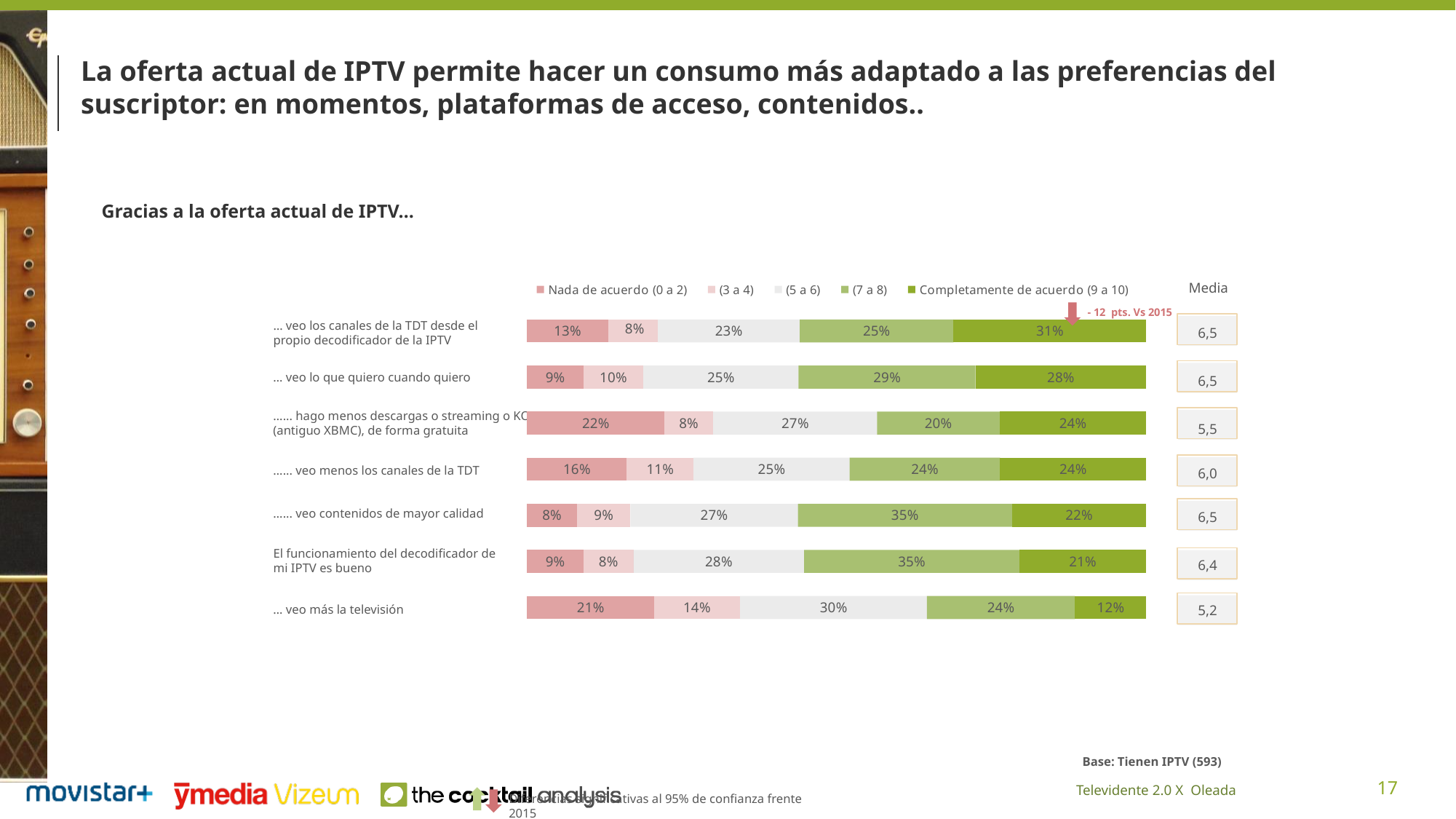
What colour represents the 'Nada de acuerdo (0 a 2)' series in the legend? Red/pink How many series does the legend list? 5 Which is larger: the '(7 a 8)' value for '...... veo contenidos de mayor calidad' or for '... veo lo que quiero cuando quiero'? ...... veo contenidos de mayor calidad Which statement has the lowest 'Completamente de acuerdo (9 a 10)' value? ... veo más la televisión What is the combined share of '(7 a 8)' and 'Completamente de acuerdo (9 a 10)' for '... veo lo que quiero cuando quiero'? 57% What is the 'Completamente de acuerdo (9 a 10)' value for '... veo los canales de la TDT desde el propio decodificador de la IPTV'? 31% What kind of chart is shown on the slide? Stacked bar chart Which statement has the highest 'Completamente de acuerdo (9 a 10)' value? ... veo los canales de la TDT desde el propio decodificador de la IPTV How many statements (categories) are plotted in the chart? 7 What is the '(5 a 6)' value for 'El funcionamiento del decodificador de mi IPTV es bueno'? 28% What is the difference between the 'Nada de acuerdo (0 a 2)' values for '...... hago menos descargas o streaming o KODI (antiguo XBMC), de forma gratuita' and '... veo lo que quiero cuando quiero'? 13% What is the 'Nada de acuerdo (0 a 2)' value for '... veo más la televisión'? 21%